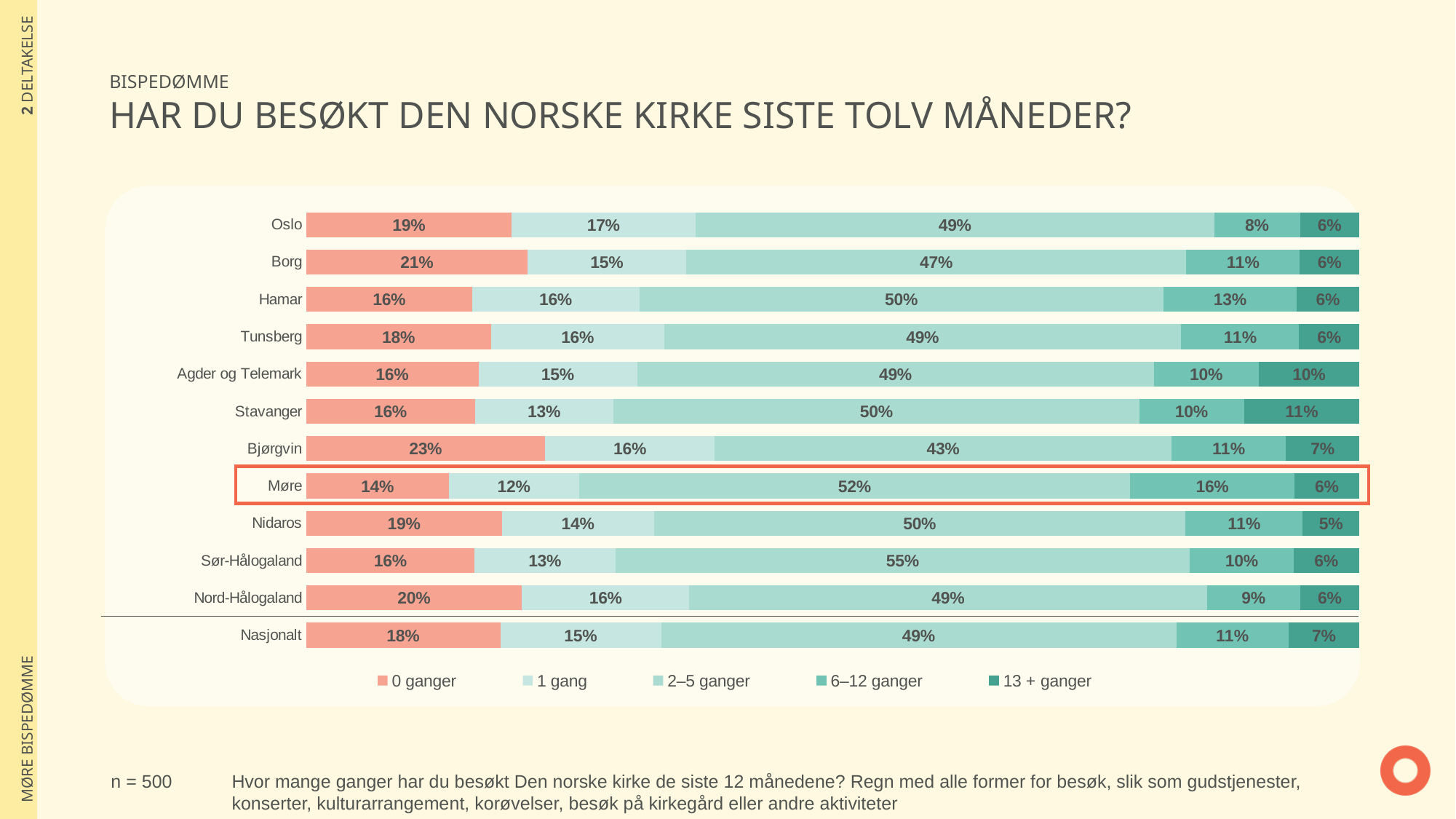
What is the value for '0 ganger' for Bjørgvin? 23% What is the value for '2–5 ganger' for Møre? 52% Which category has the highest value for '2–5 ganger'? Sør-Hålogaland Which is larger: the '13 + ganger' value for Stavanger or for Oslo? Stavanger Which category has the lowest value for '0 ganger'? Møre How many categories (rows) are plotted in the chart, including Nasjonalt? 12 How many series does the legend list? 5 What is the value for '13 + ganger' for Nasjonalt? 7% Which category has the highest value for '6–12 ganger'? Møre What kind of chart is shown on the slide? Stacked bar chart Which category's row is highlighted with a red outline? Møre What is the difference between the '0 ganger' values for Bjørgvin and Møre? 9 percentage points